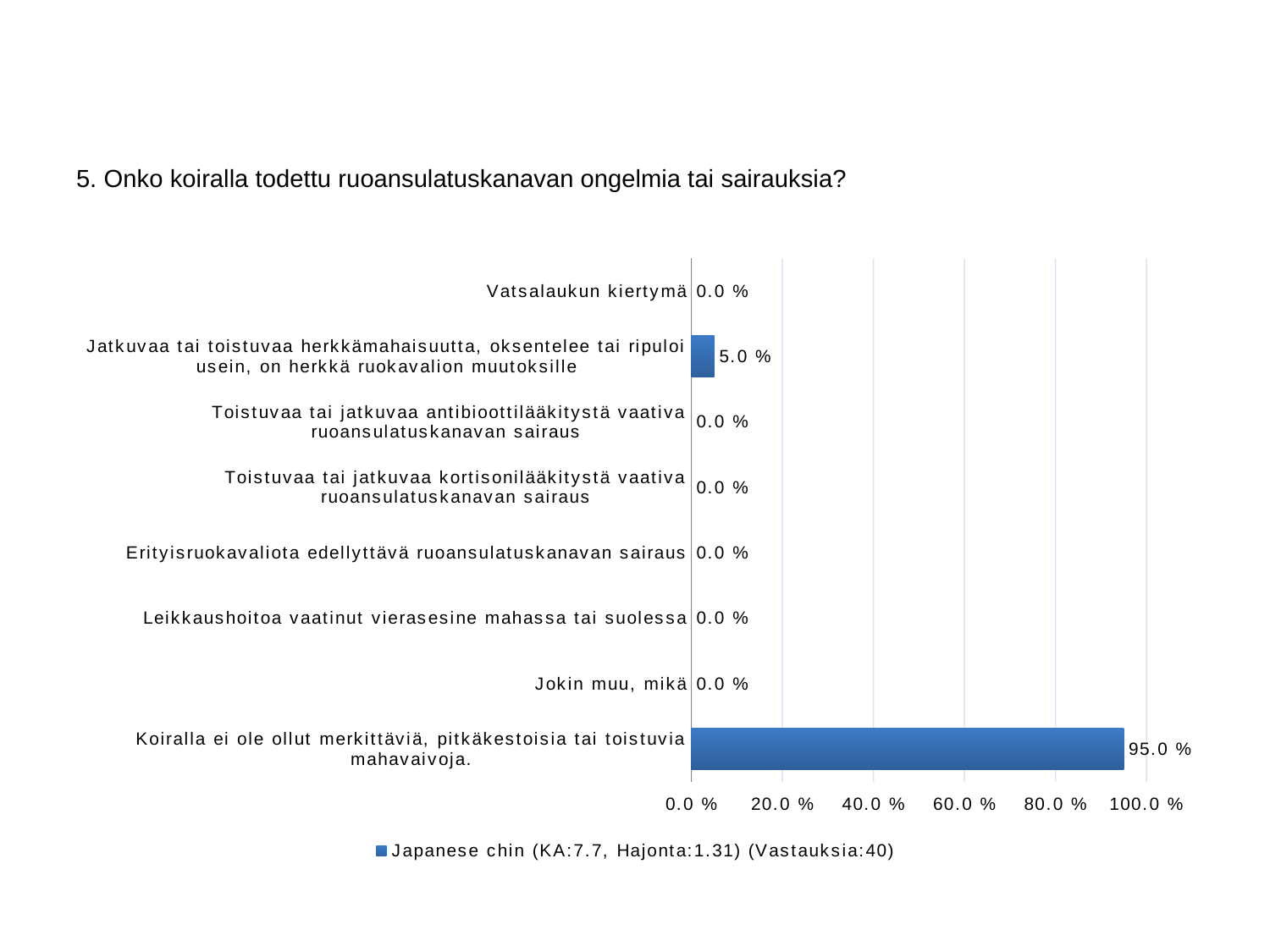
What is the value for "Jokin muu, mikä"? 0.0 % What is the value for "Vatsalaukun kiertymä"? 0.0 % What is the difference between the value for "Koiralla ei ole ollut merkittäviä, pitkäkestoisia tai toistuvia mahavaivoja." and the value for "Jatkuvaa tai toistuvaa herkkämahaisuutta, oksentelee tai ripuloi usein, on herkkä ruokavalion muutoksille"? 90.0 % What is the legend entry of the chart? Japanese chin (KA:7.7, Hajonta:1.31) (Vastauksia:40) How many series does the legend list? 1 What is the value for "Koiralla ei ole ollut merkittäviä, pitkäkestoisia tai toistuvia mahavaivoja."? 95.0 % How many categories are shown in the chart? 8 What kind of chart is shown on the slide? bar chart Is the value for "Koiralla ei ole ollut merkittäviä, pitkäkestoisia tai toistuvia mahavaivoja." greater or less than 80.0 %? greater Which category has the highest value? Koiralla ei ole ollut merkittäviä, pitkäkestoisia tai toistuvia mahavaivoja. What is the value for "Jatkuvaa tai toistuvaa herkkämahaisuutta, oksentelee tai ripuloi usein, on herkkä ruokavalion muutoksille"? 5.0 % Which is larger: the value for "Jatkuvaa tai toistuvaa herkkämahaisuutta, oksentelee tai ripuloi usein, on herkkä ruokavalion muutoksille" or the value for "Vatsalaukun kiertymä"? Jatkuvaa tai toistuvaa herkkämahaisuutta, oksentelee tai ripuloi usein, on herkkä ruokavalion muutoksille